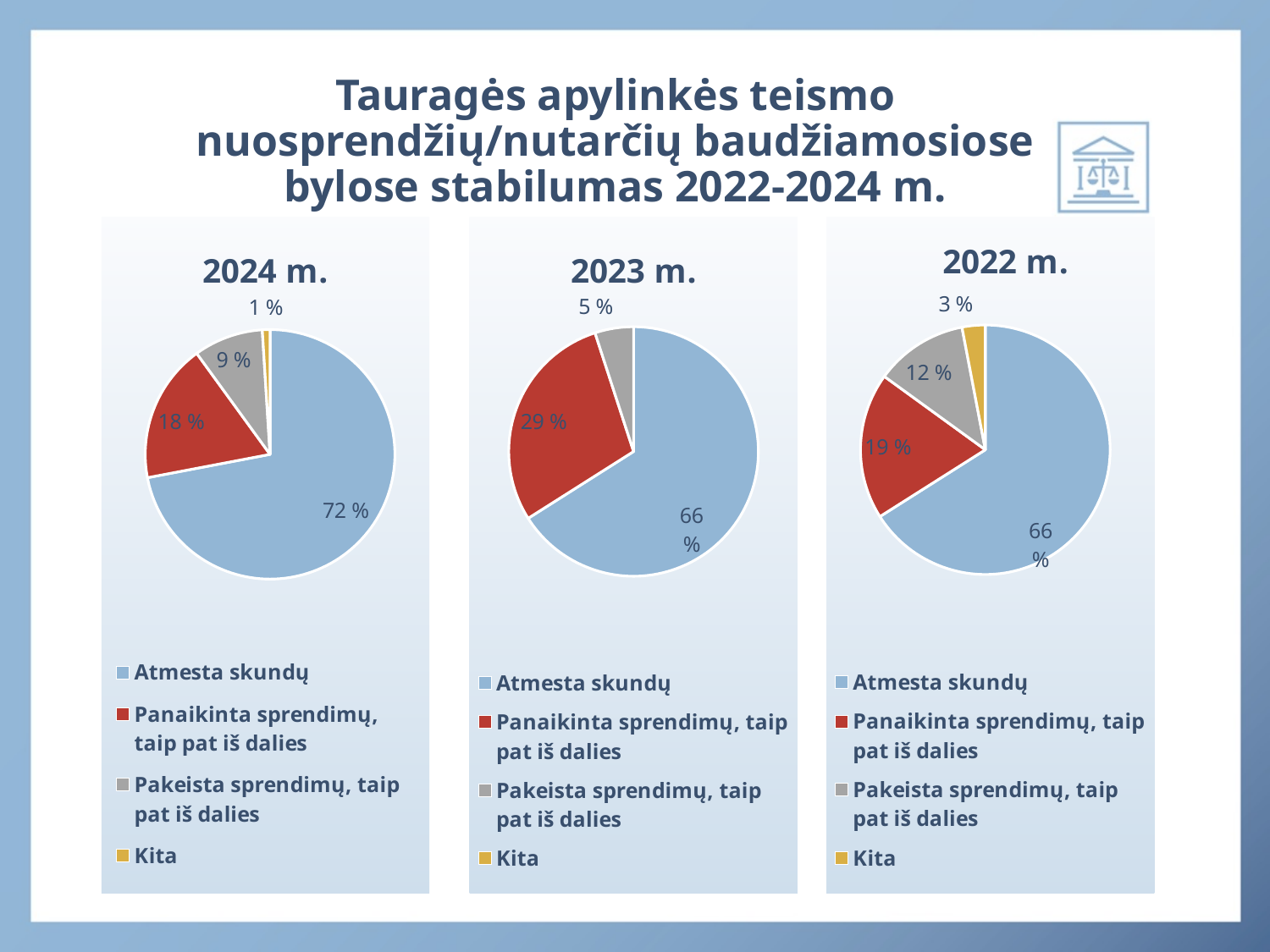
In the 2023 m. pie chart, what share is labelled for Panaikinta sprendimų, taip pat iš dalies? 29 % Which is larger: the Pakeista sprendimų share in the 2022 m. chart or in the 2024 m. chart? 2022 m. In the 2024 m. pie chart, which category has the smallest labelled slice? Kita In the 2023 m. pie chart, which category has the smallest labelled slice? Pakeista sprendimų, taip pat iš dalies In the 2022 m. pie chart, what share is labelled for Pakeista sprendimų, taip pat iš dalies? 12 % What type of chart is used for the 2023 m. data? Pie chart How many entries does the legend of the 2022 m. chart list? 4 What is the difference between the Panaikinta sprendimų share in the 2023 m. chart and in the 2024 m. chart? 11 % In the 2024 m. pie chart, what share is labelled for Atmesta skundų? 72 % In the 2022 m. pie chart, what share is labelled for Kita? 3 % In the 2024 m. pie chart, what colour is the Kita slice? Yellow In the 2024 m. pie chart, which category has the largest slice? Atmesta skundų